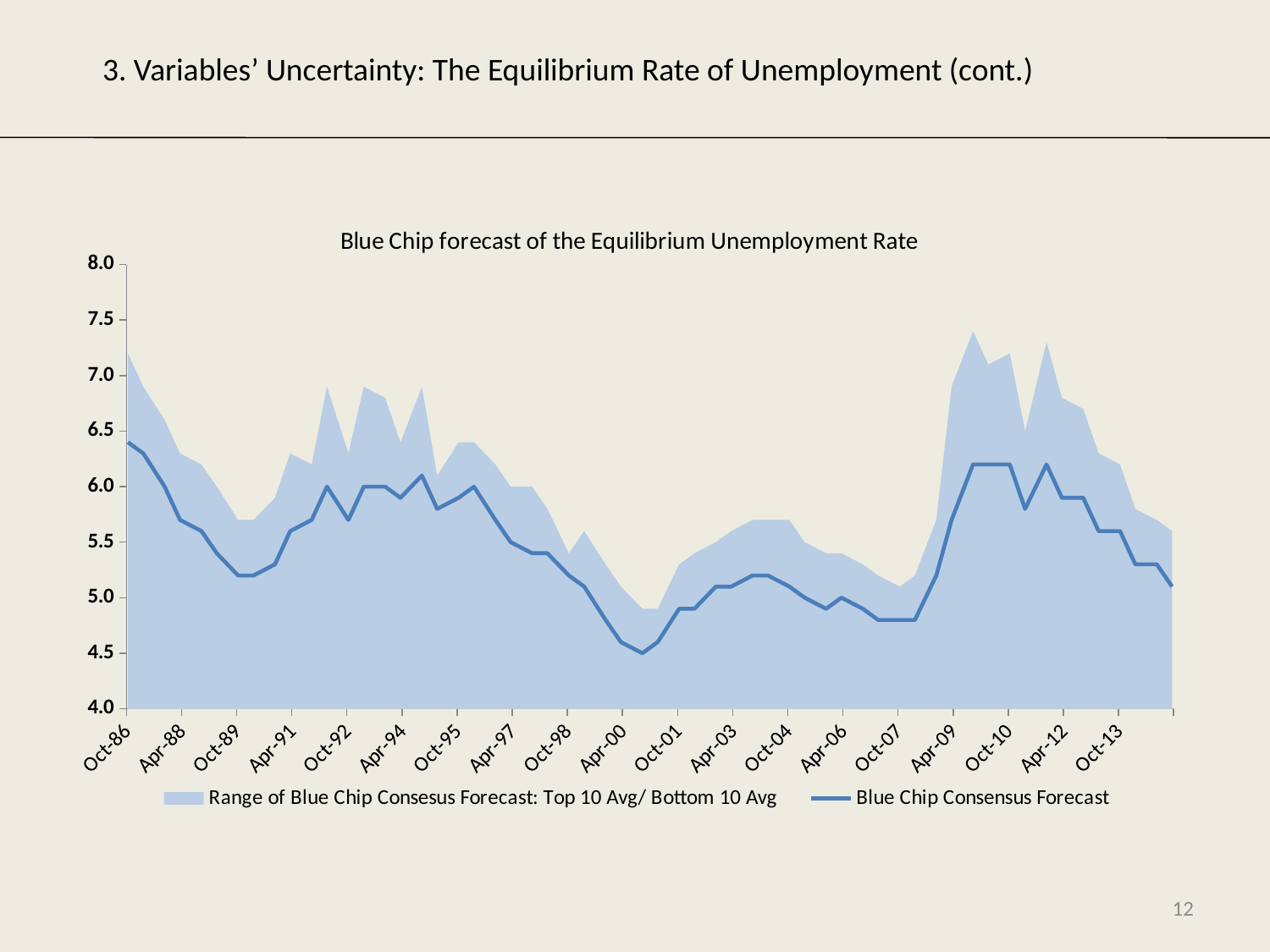
What is the name of the shaded-area series in the legend? Range of Blue Chip Consesus Forecast: Top 10 Avg/ Bottom 10 Avg Does the Blue Chip Consensus Forecast rise or fall between Oct-07 and Oct-10? rise Does the Blue Chip Consensus Forecast rise or fall between Oct-10 and Oct-13? fall Is the Blue Chip Consensus Forecast value at Apr-00 greater or less than 5.0? less Which is larger, the Blue Chip Consensus Forecast at Oct-86 or at Apr-00? Oct-86 Which of the labelled dates has the lowest Blue Chip Consensus Forecast value? Apr-00 Is the Blue Chip Consensus Forecast value at Oct-07 greater or less than 5.0? less Is the Blue Chip Consensus Forecast value at Oct-10 greater or less than 6.0? greater What kind of chart is shown on the slide? combination area and line chart How many series does the legend list? 2 What is the title of the chart? Blue Chip forecast of the Equilibrium Unemployment Rate